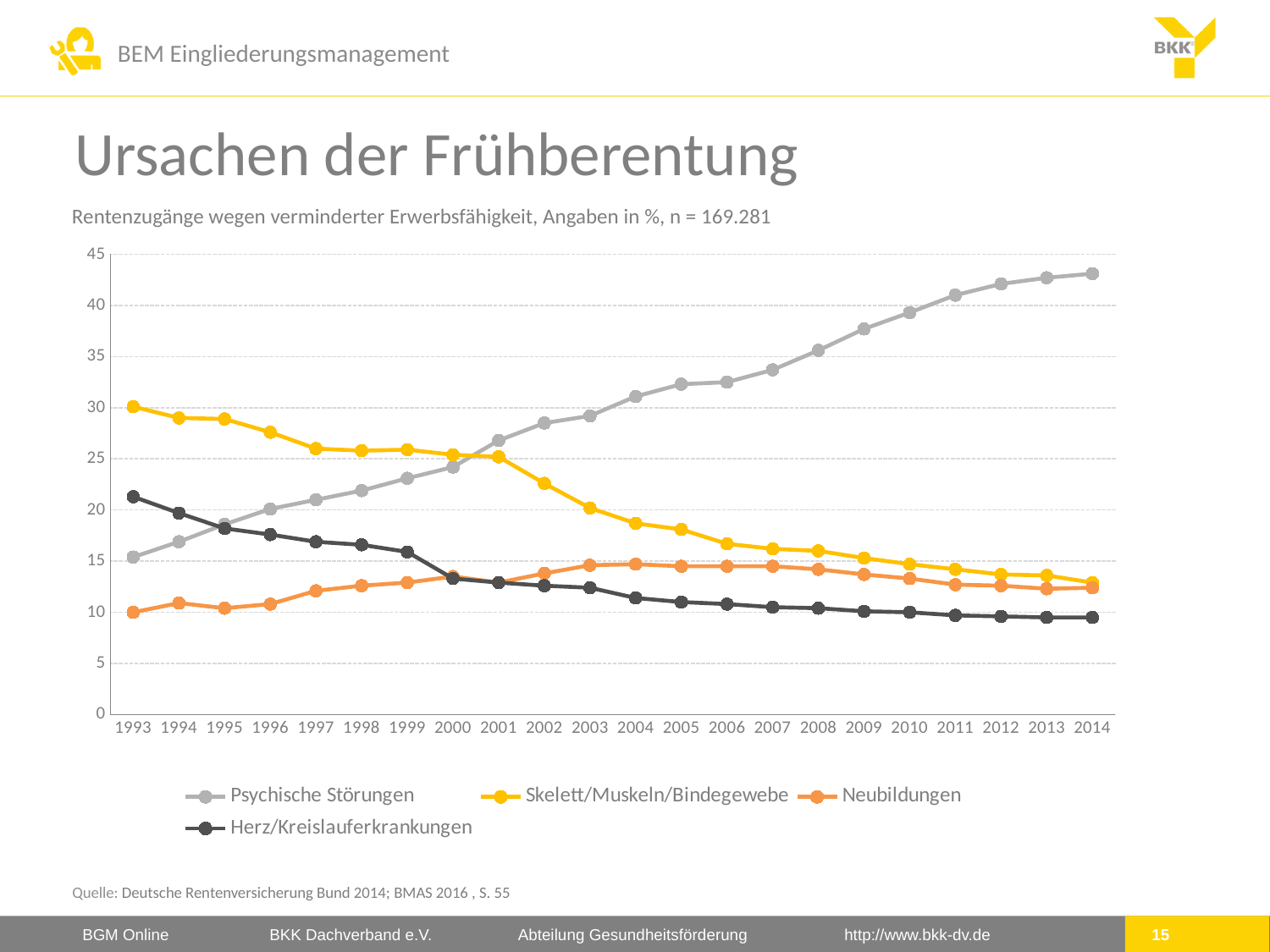
In 1993, which is higher: Psychische Störungen or Skelett/Muskeln/Bindegewebe? Skelett/Muskeln/Bindegewebe Is the value for Psychische Störungen in 2014 greater or less than 40? greater Does the value for Herz/Kreislauferkrankungen rise or fall from 1993 to 2014? fall Which series has the lowest value in 2014? Herz/Kreislauferkrankungen Is the value for Neubildungen in 1993 greater or less than 15? less Does the value for Psychische Störungen rise or fall from 1993 to 2014? rise How many years are plotted along the x axis? 22 How many series does the legend list? 4 Does the value for Skelett/Muskeln/Bindegewebe rise or fall from 1993 to 2014? fall What kind of chart is shown on the slide? line chart Which series has the highest value in 2014? Psychische Störungen Is the value for Skelett/Muskeln/Bindegewebe in 1993 greater or less than 25? greater